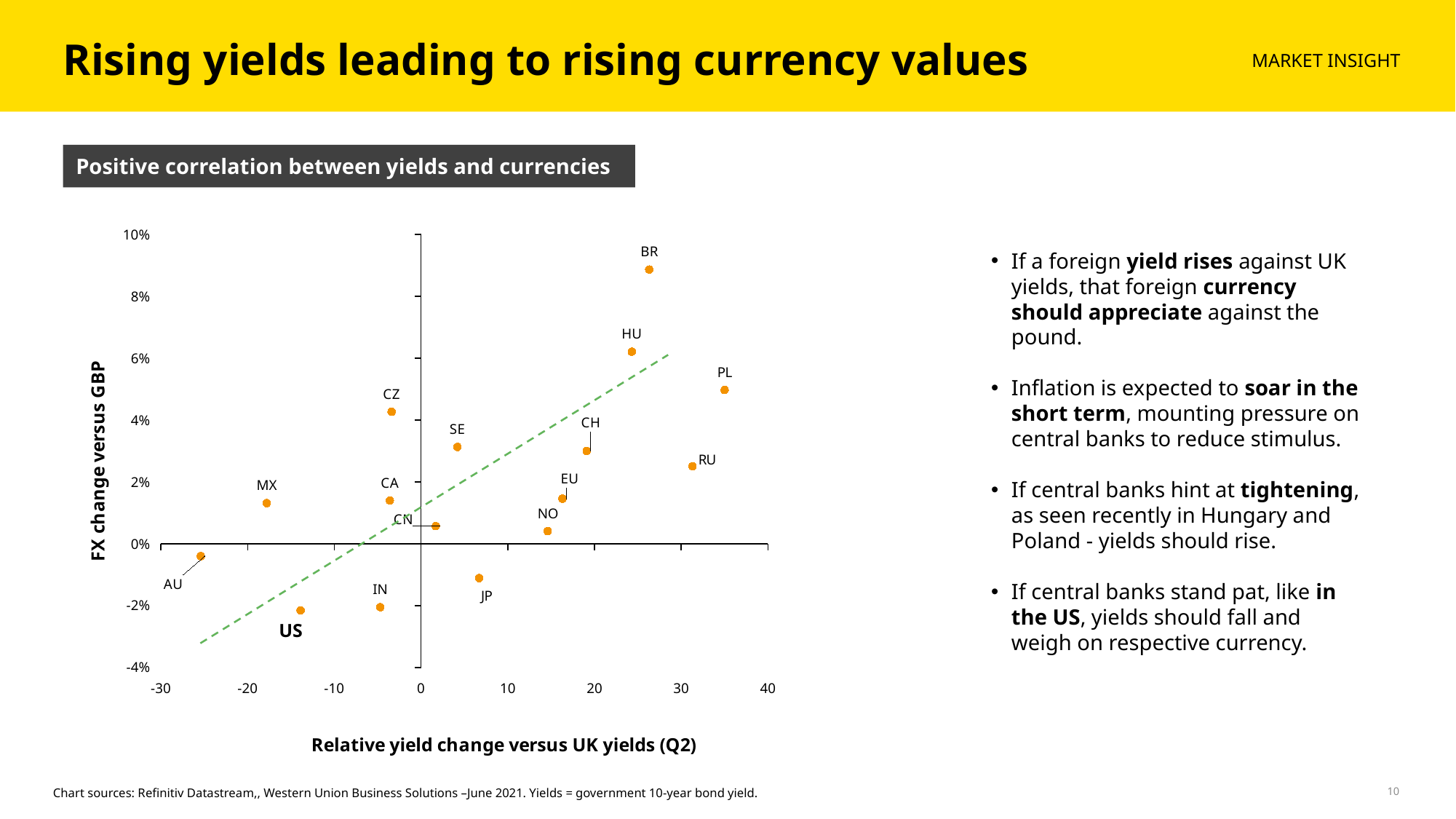
What is the title of the chart? Positive correlation between yields and currencies How many country points are plotted on the chart? 16 Is the FX change versus GBP for MX greater or less than 2%? less Does the dashed trend line rise or fall as the relative yield change increases along the x axis? Rises Is the FX change versus GBP for RU greater or less than 4%? less Is the FX change versus GBP for BR greater or less than 8%? greater Which country has the lowest relative yield change versus UK yields (furthest left on the x axis)? AU What kind of chart is shown on the slide? Scatter chart Which has a higher FX change versus GBP, CZ or CA? CZ Which country has the highest FX change versus GBP? BR Which country has the highest relative yield change versus UK yields (furthest right on the x axis)? PL